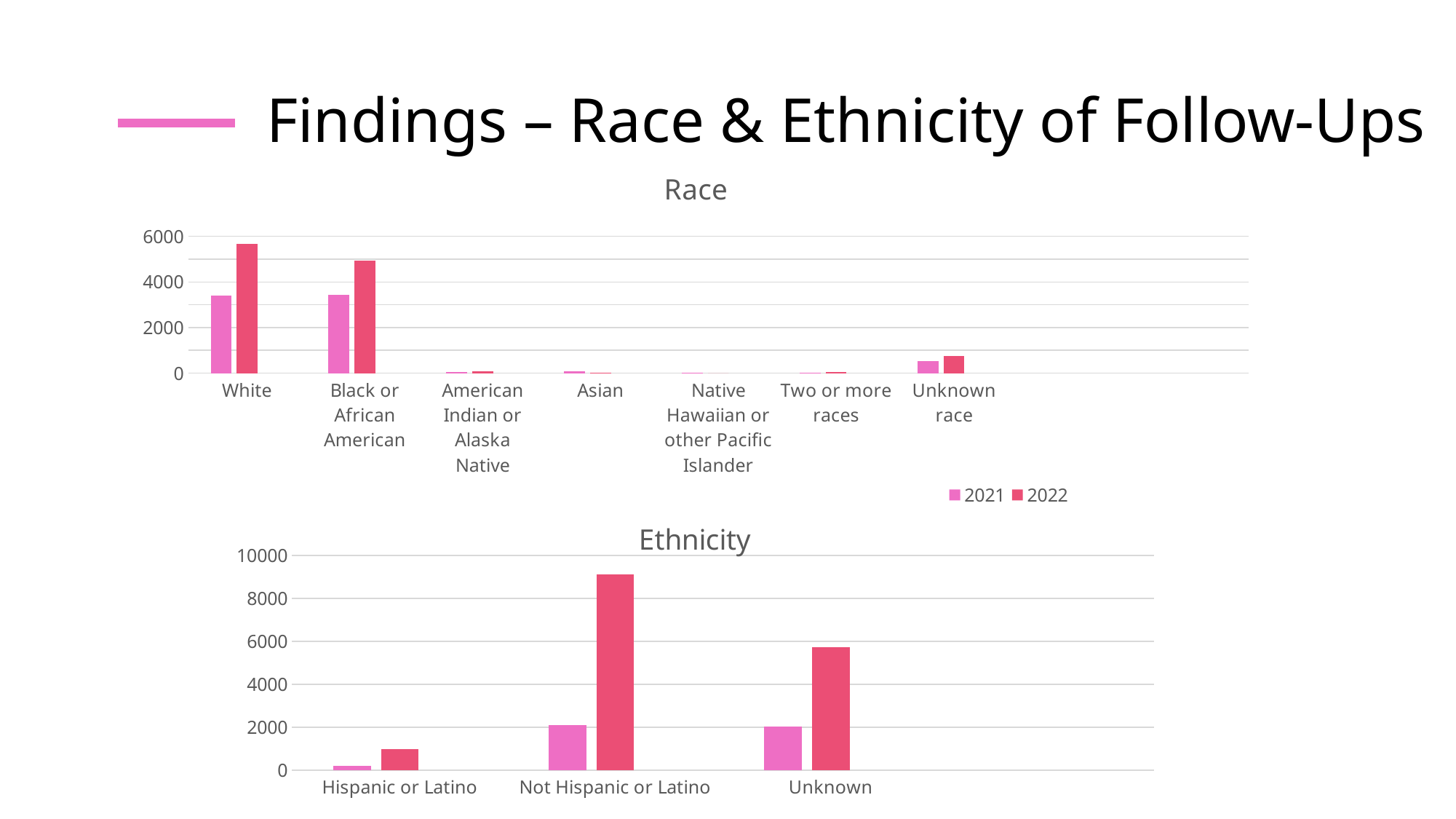
On the Race chart, which category has the highest value for 2022? White On the Ethnicity chart, which category has the highest value for 2022? Not Hispanic or Latino What are the two series named in the legend on the slide? 2021 and 2022 On the Race chart, which is larger for 2022: White or Unknown race? White On the Ethnicity chart, is the 2022 value for Not Hispanic or Latino greater or less than 8000? greater On the Ethnicity chart, which category has the lowest value for 2021? Hispanic or Latino How many series does the legend on the Race chart list? 2 On the Race chart, is the 2022 value for Unknown race greater or less than 2000? less What type of chart is the Race chart? bar chart On the Race chart, is the 2022 value for Black or African American greater or less than 4000? greater How many ethnicity categories are shown on the Ethnicity chart? 3 How many race categories are shown on the Race chart? 7